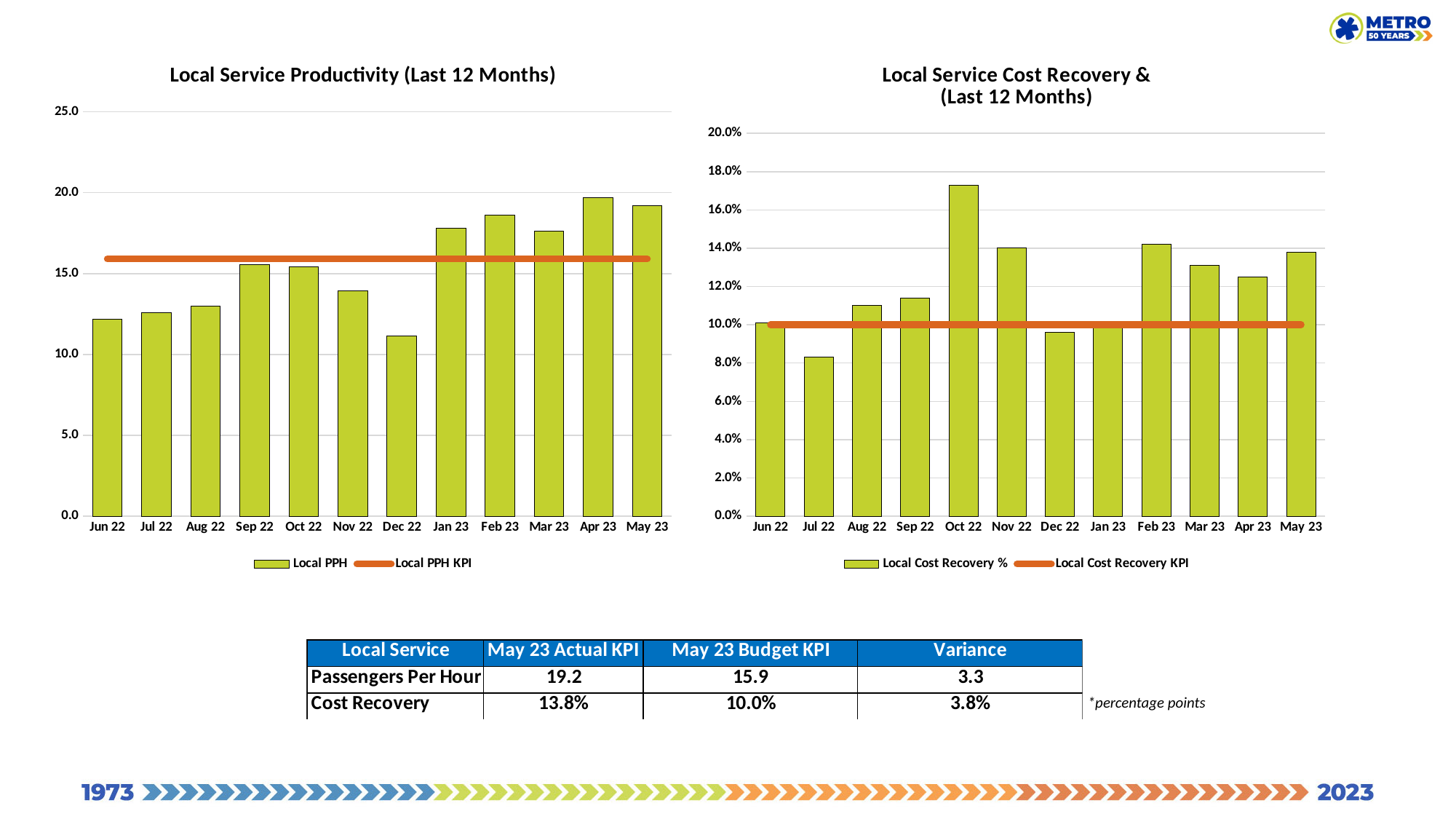
In the Local Service Productivity chart, which month has the lowest Local PPH bar? Dec 22 What kind of chart is the Local Service Productivity chart? combination bar and line chart In the Local Service Cost Recovery chart, which is larger, the Local Cost Recovery % for Nov 22 or for Dec 22? Nov 22 In the Local Service Productivity chart, is the Local PPH value for Feb 23 greater or less than 15.0? greater In the Local Service Productivity chart, how many months are shown on the x axis? 12 In the Local Service Productivity chart, is the Local PPH value for Dec 22 greater or less than 15.0? less In the Local Service Cost Recovery chart, which month has the highest Local Cost Recovery % bar? Oct 22 In the Local Service Productivity chart, which month has the highest Local PPH bar? Apr 23 In the Local Service Cost Recovery chart, is the Local Cost Recovery % for Oct 22 greater or less than 16.0%? greater In the Local Service Cost Recovery chart, which month has the lowest Local Cost Recovery % bar? Jul 22 In the Local Service Productivity chart, how many series does the legend list? 2